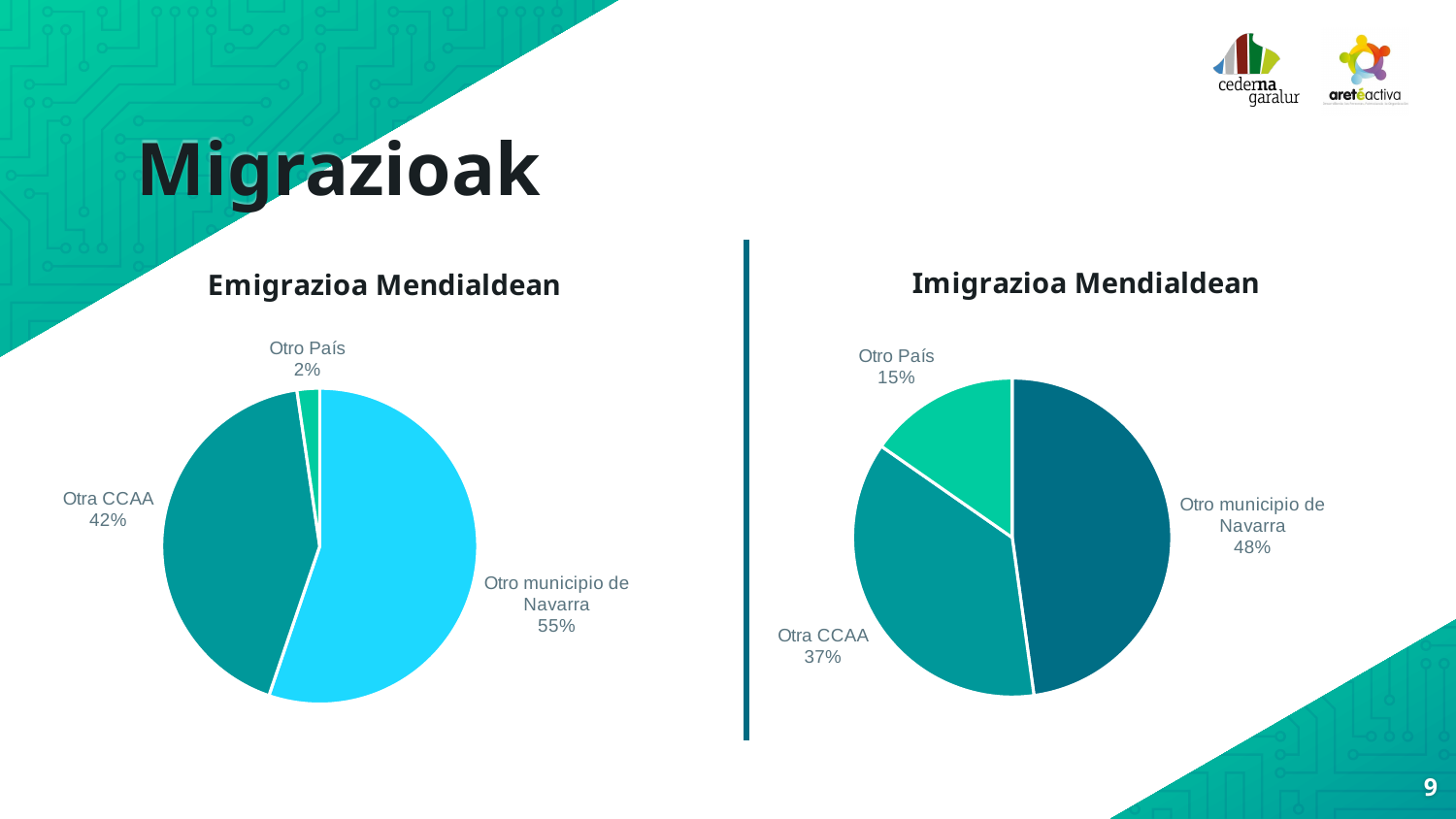
In the 'Emigrazioa Mendialdean' chart, which category has the smallest slice? Otro País What type of chart is 'Emigrazioa Mendialdean'? Pie chart How many categories are shown in the 'Imigrazioa Mendialdean' chart? 3 In the 'Imigrazioa Mendialdean' chart, what share does 'Otro País' have? 15% In the 'Emigrazioa Mendialdean' chart, what share does 'Otra CCAA' have? 42% In the 'Imigrazioa Mendialdean' chart, which category has the largest slice? Otro municipio de Navarra What is the title of the chart on the right side of the slide? Imigrazioa Mendialdean Which chart shows a larger share for 'Otro País', 'Emigrazioa Mendialdean' or 'Imigrazioa Mendialdean'? Imigrazioa Mendialdean In the 'Emigrazioa Mendialdean' chart, what share does 'Otro municipio de Navarra' have? 55% In the 'Imigrazioa Mendialdean' chart, what is the difference between the shares of 'Otra CCAA' and 'Otro País'? 22% In the 'Emigrazioa Mendialdean' chart, what is the difference between the shares of 'Otro municipio de Navarra' and 'Otra CCAA'? 13% In the 'Imigrazioa Mendialdean' chart, what share does 'Otra CCAA' have? 37%